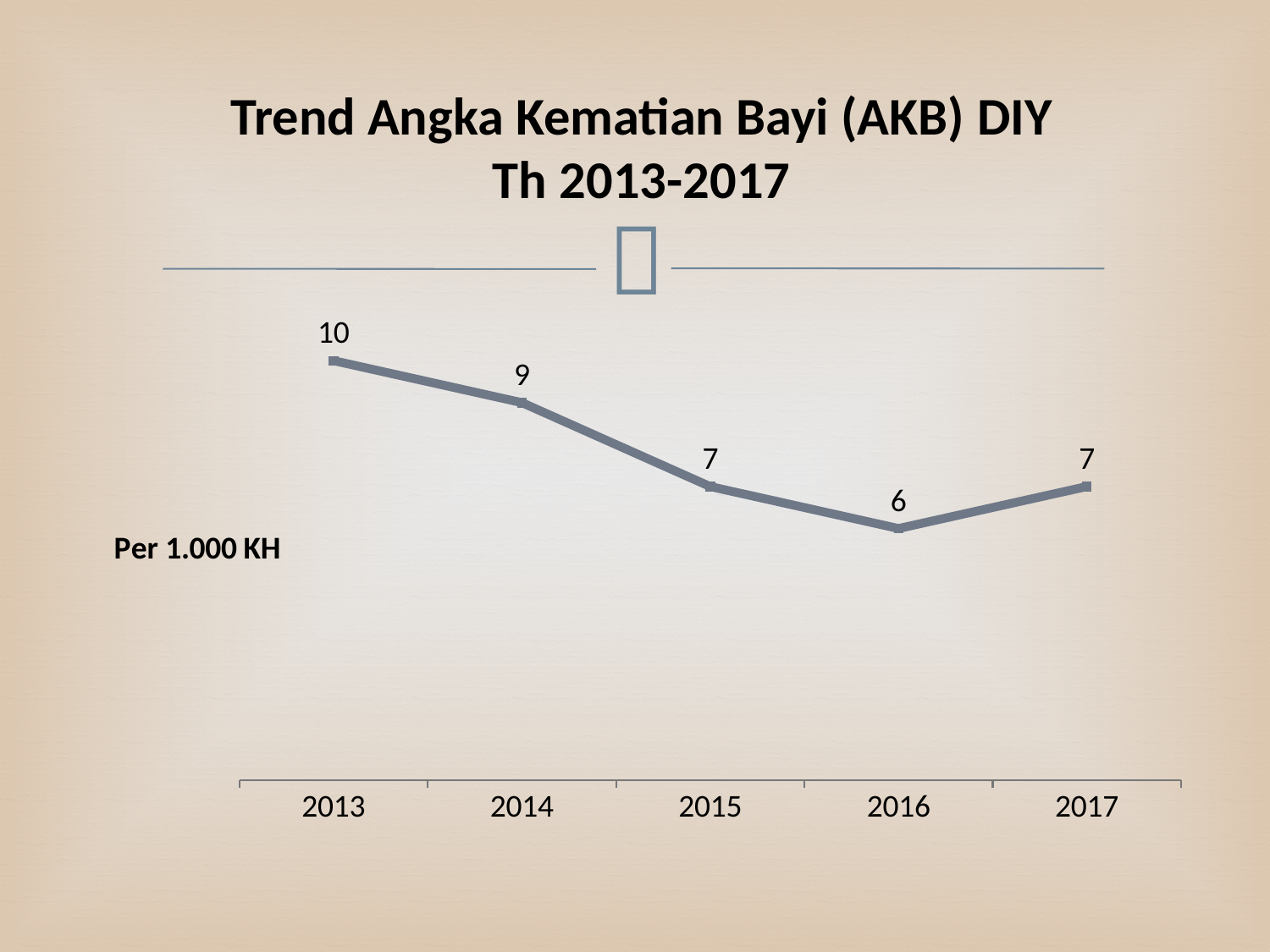
What kind of chart is shown on the slide? line chart Which year has the lowest value? 2016 Do the values rise or fall from 2013 to 2016? fall What is the difference between the values for 2013 and 2016? 4 What is the difference between the values for 2014 and 2015? 2 Which year has the highest value? 2013 How many years are plotted on the chart? 5 Which is larger, the value for 2014 or the value for 2017? 2014 What is the value for 2017? 7 What is the value for 2014? 9 What is the value for 2016? 6 What is the value for 2013? 10